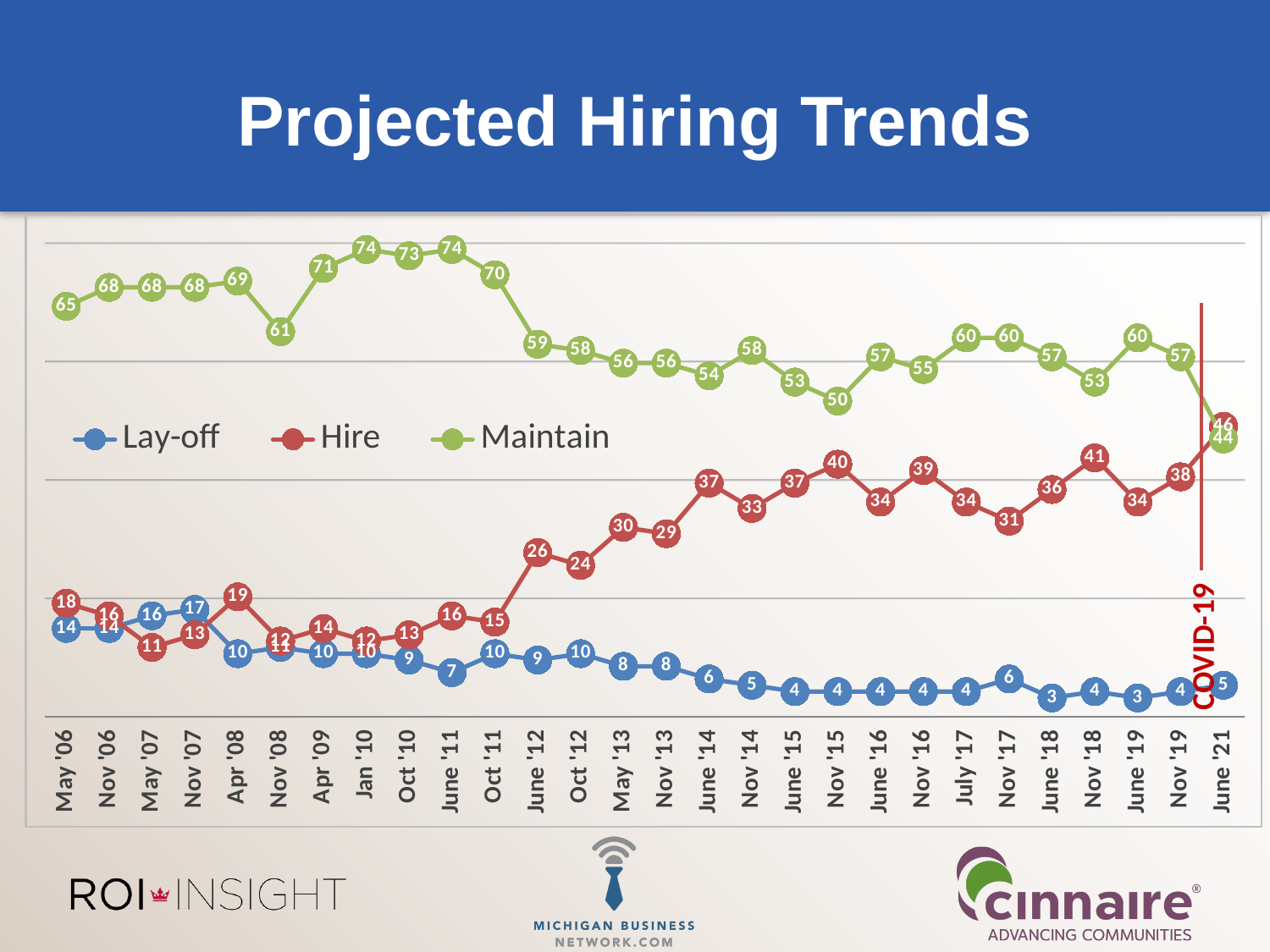
Does the Lay-off series generally rise or fall from May '06 to June '21? fall What text is written next to the vertical red line near the right side of the chart? COVID-19 How many series does the legend list? 3 What is the Lay-off value for Nov '07? 17 At which date does the Hire series reach its highest value? June '21 Which is larger: the Hire value at Nov '15 or the Hire value at Nov '17? Nov '15 What kind of chart is shown on the slide? line chart What is the Hire value for June '21? 46 What is the Maintain value for Jan '10? 74 What is the Lay-off value for June '18? 3 At which date does the Maintain series reach its lowest value? June '21 What is the difference between the Hire and Maintain values at June '21? 2